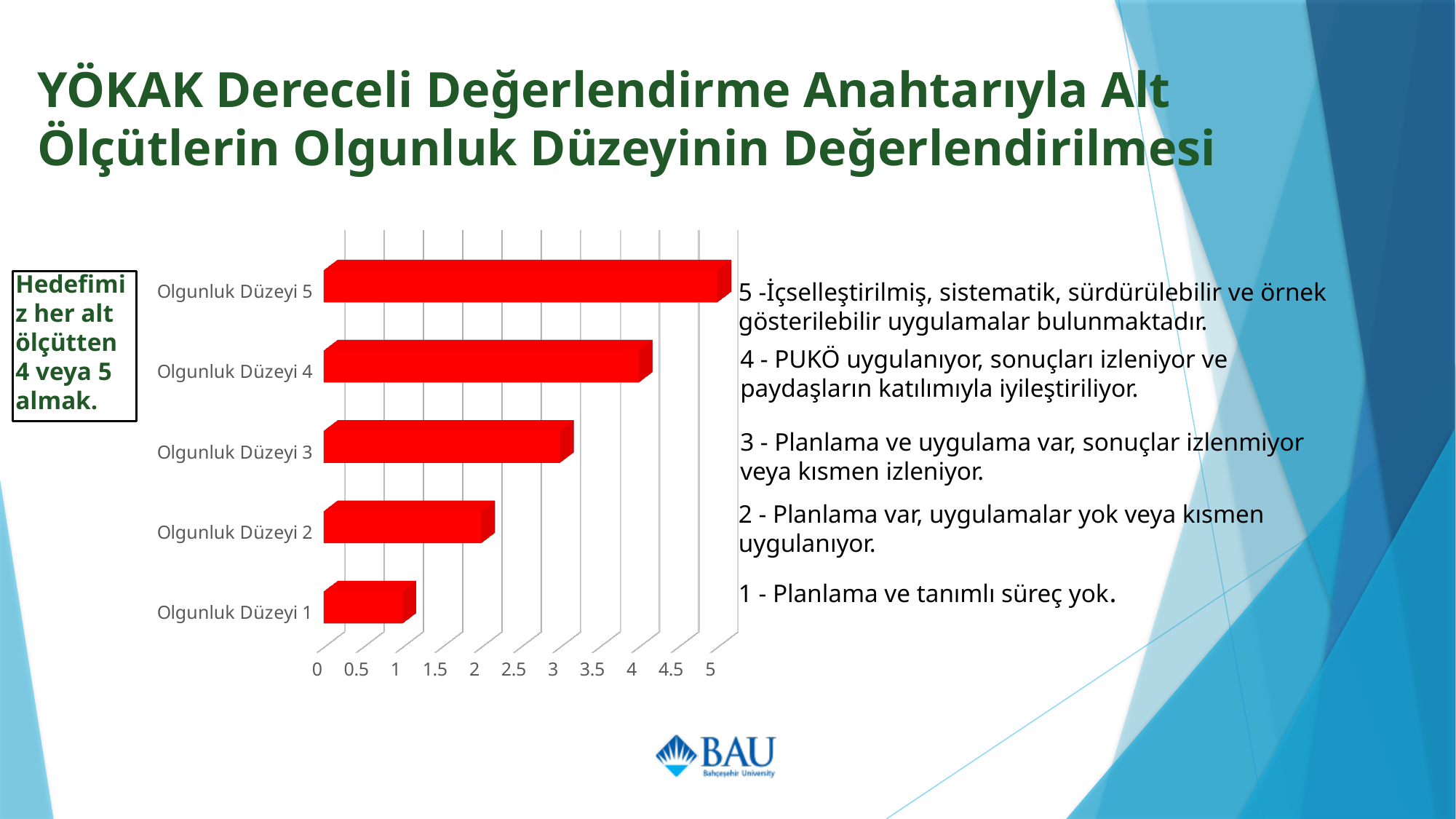
What colour are the bars in the chart? red How many categories (bars) does the chart show? 5 Which is larger, the value for Olgunluk Düzeyi 3 or Olgunluk Düzeyi 2? Olgunluk Düzeyi 3 Is the value for Olgunluk Düzeyi 5 greater or less than 4? greater Is the value for Olgunluk Düzeyi 1 greater or less than 2? less What kind of chart is shown on the slide? bar chart Do the bar values increase or decrease going from Olgunluk Düzeyi 1 up to Olgunluk Düzeyi 5? increase Is the value for Olgunluk Düzeyi 4 greater or less than 3? greater Which category has the longest bar? Olgunluk Düzeyi 5 Which category has the shortest bar? Olgunluk Düzeyi 1 Which is larger, the value for Olgunluk Düzeyi 4 or Olgunluk Düzeyi 5? Olgunluk Düzeyi 5